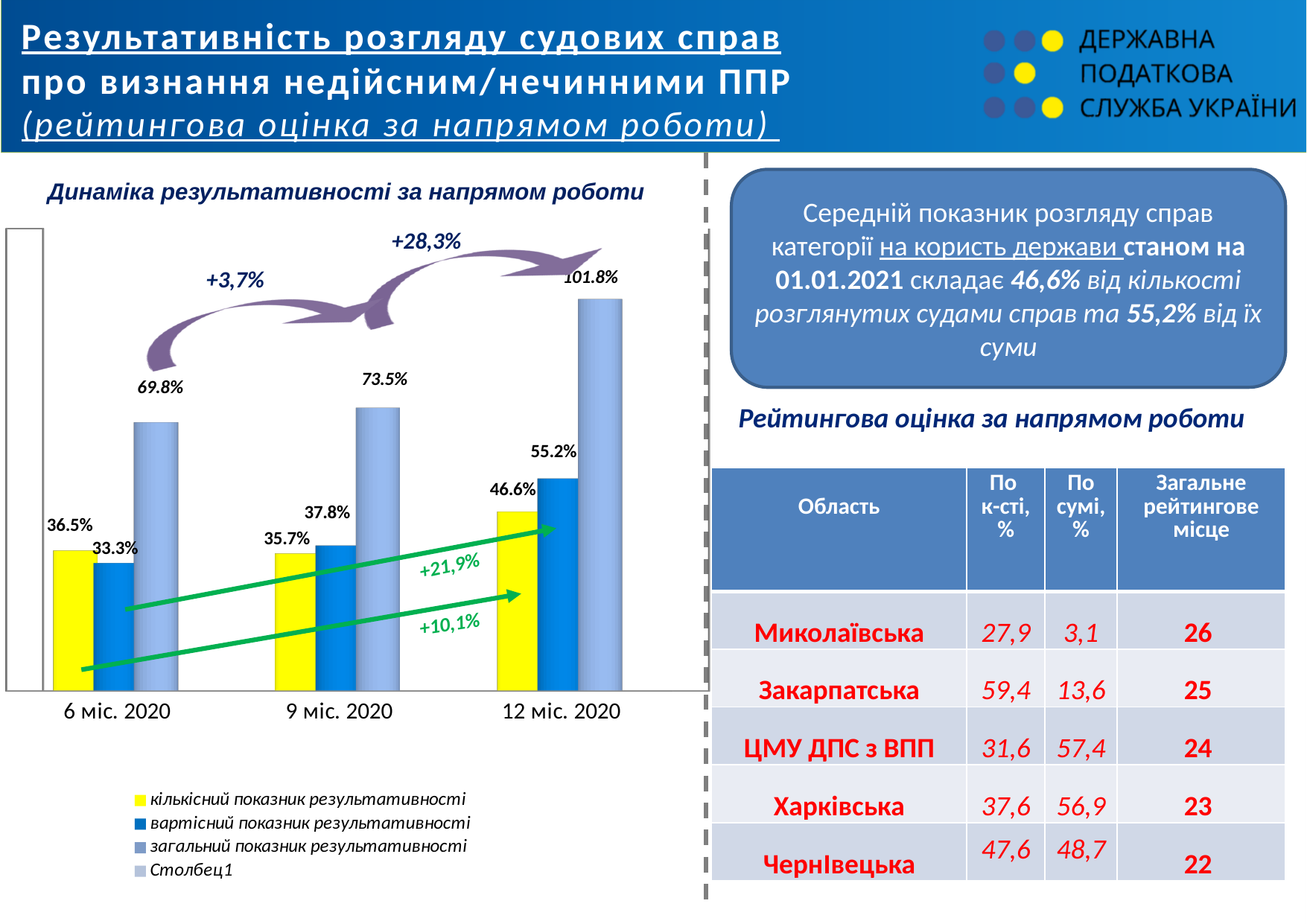
Which is larger for 6 міс. 2020: the кількісний показник результативності or the вартісний показник результативності? кількісний показник результативності For which period is the загальний показник результативності highest? 12 міс. 2020 What kind of chart is shown under the title "Динаміка результативності за напрямом роботи"? bar chart How many entries does the chart legend list? 4 What is the difference between the загальний показник результативності for 12 міс. 2020 and for 9 міс. 2020? 28.3% What is the value of the вартісний показник результативності for 12 міс. 2020? 55.2% For which period is the кількісний показник результативності lowest? 9 міс. 2020 What is the value of the вартісний показник результативності for 9 міс. 2020? 37.8% How many periods are shown on the x axis of the chart? 3 Does the вартісний показник результативності rise or fall from 6 міс. 2020 to 12 міс. 2020? rise What is the value of the загальний показник результативності for 12 міс. 2020? 101.8% What is the value of the кількісний показник результативності for 6 міс. 2020? 36.5%